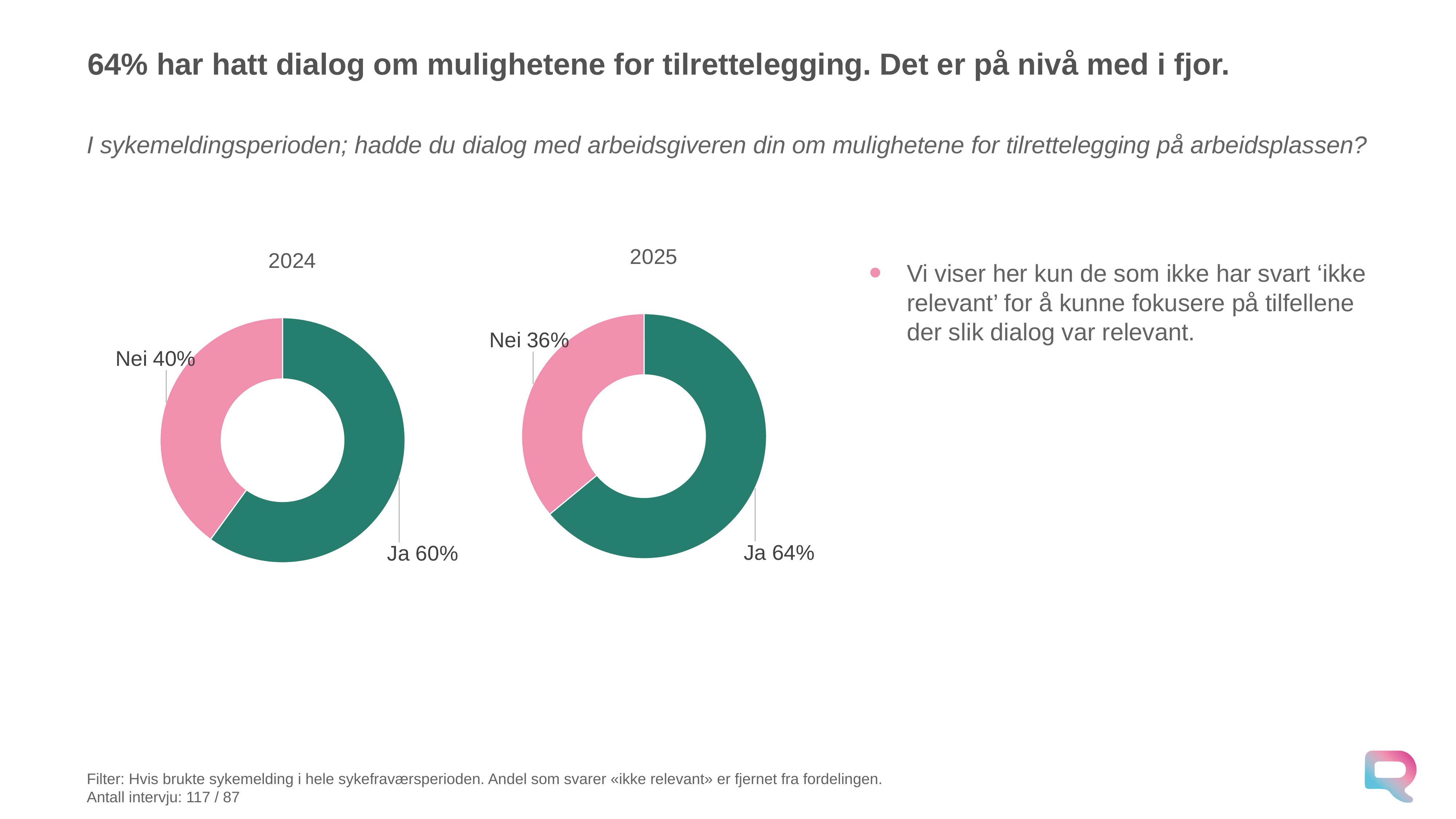
In the 2024 chart, what colour is the Ja slice? Green In the 2025 chart, which category has the largest share? Ja In the 2024 chart, what is the value for Nei? 40% Is the value for Ja larger in the 2024 chart or the 2025 chart? 2025 How many categories does the 2024 chart show? 2 In the 2024 chart, which category has the smallest share? Nei In the 2025 chart, what is the value for Ja? 64% In the 2025 chart, what is the value for Nei? 36% In the 2025 chart, what is the difference between Ja and Nei? 28 percentage points What kind of chart is the 2025 chart? Doughnut chart In the 2024 chart, what is the value for Ja? 60% What is the difference between the Nei value in the 2024 chart and the Nei value in the 2025 chart? 4 percentage points